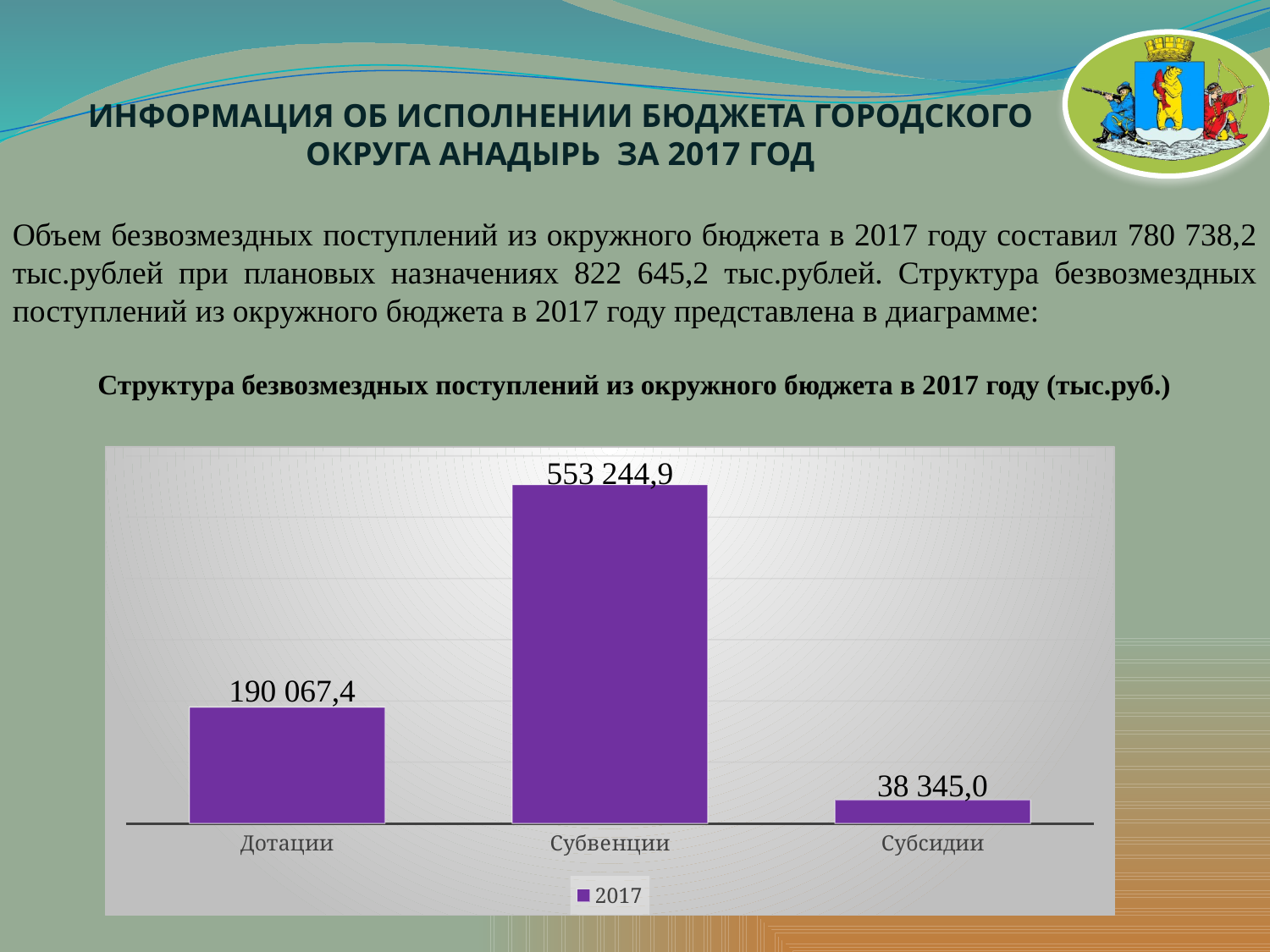
Which is larger, the value for Дотации or the value for Субсидии? Дотации Which category has the lowest value in the chart? Субсидии What is the value for Субвенции in the chart? 553 244,9 What series name is shown in the chart legend? 2017 What is the value for Субсидии in the chart? 38 345,0 What is the difference between the values for Дотации and Субсидии? 151 722,4 How many categories are shown in the chart? 3 Which category has the highest value in the chart? Субвенции What is the difference between the values for Субвенции and Дотации? 363 177,5 What kind of chart is shown on the slide? Bar chart What is the value for Дотации in the chart? 190 067,4 How many series does the legend list? 1